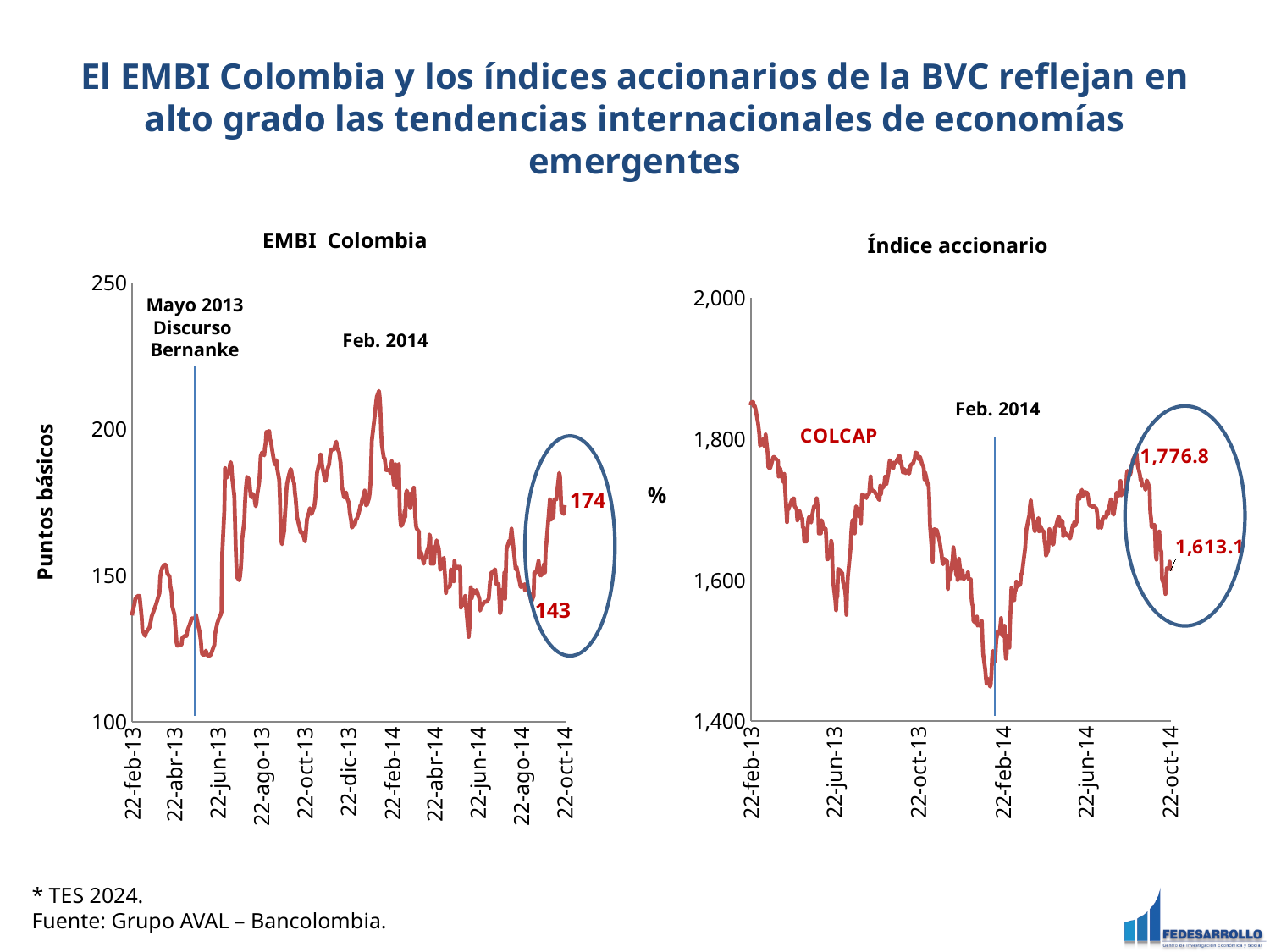
In the Índice accionario chart, does the COLCAP rise or fall between the Feb. 2014 line and 22-jun-14? Rise In the EMBI Colombia chart, what is the difference between the two labelled values 174 and 143? 31 What kind of chart is the EMBI Colombia chart on the left? Line chart In the Índice accionario chart, what is the difference between the labelled values 1,776.8 and 1,613.1? 163.7 In the Índice accionario chart, is the value at the Feb. 2014 vertical line greater or less than 1,600? less In the EMBI Colombia chart, is the value at 22-feb-13 greater or less than 150? less What is the y-axis label of the EMBI Colombia chart? Puntos básicos In the EMBI Colombia chart, what is the lower of the two values labelled inside the circled area? 143 In the EMBI Colombia chart, what is the higher of the two values labelled inside the circled area? 174 What kind of chart is the Índice accionario chart on the right? Line chart In the Índice accionario chart, what is the higher labelled value in the circled area? 1,776.8 In the Índice accionario chart, what is the lower labelled value in the circled area? 1,613.1